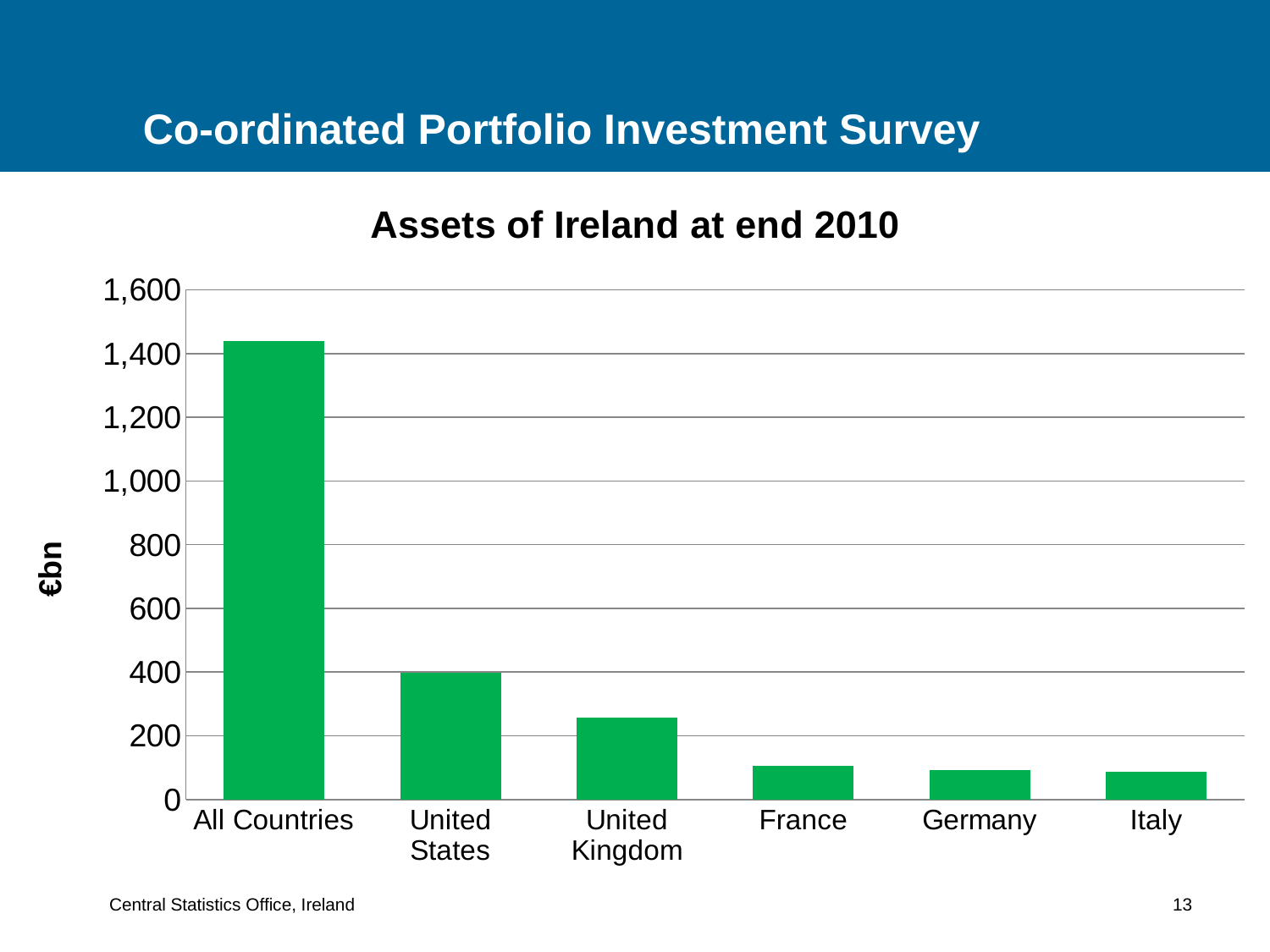
Do the values rise or fall moving from left to right along the x axis? fall Which category has the highest value? All Countries Is the value for United States greater or less than 600? less Is the value for France greater or less than 200? less What type of chart is shown on the slide? bar chart Which is larger, the value for United States or the value for United Kingdom? United States Is the value for United Kingdom greater or less than 200? greater What unit is shown on the vertical axis label? €bn What is the title of the chart? Assets of Ireland at end 2010 How many categories are shown on the x axis? 6